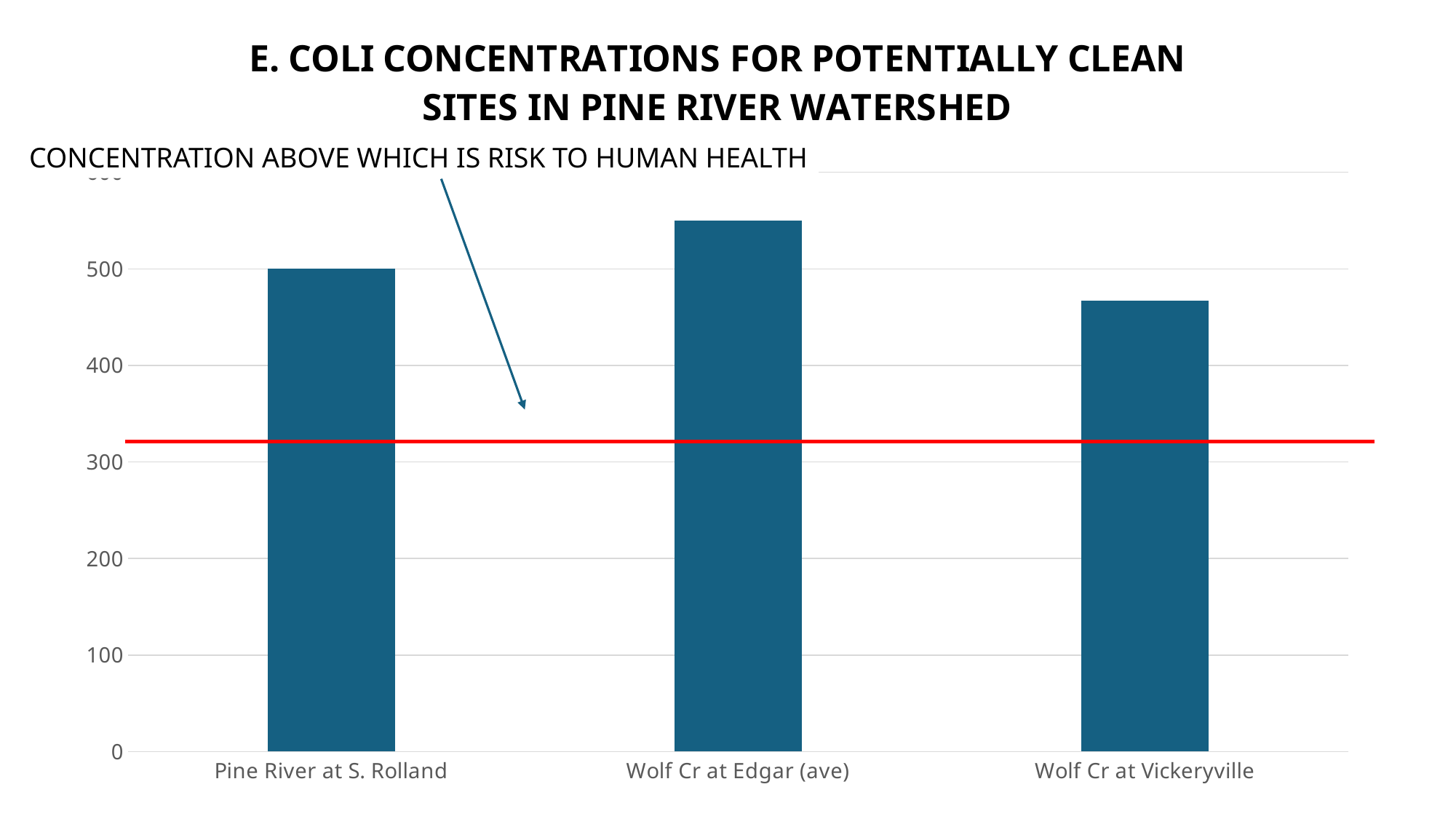
Is the value for Wolf Cr at Edgar (ave) greater or less than 500? greater Is the value for Wolf Cr at Vickeryville greater or less than 500? less What kind of chart is shown on the slide? Bar chart What is the title of the chart? E. COLI CONCENTRATIONS FOR POTENTIALLY CLEAN SITES IN PINE RIVER WATERSHED Which site has the lowest E. coli concentration? Wolf Cr at Vickeryville Is the value for Wolf Cr at Vickeryville greater or less than 400? greater Which is larger, the value for Pine River at S. Rolland or the value for Wolf Cr at Vickeryville? Pine River at S. Rolland What is the E. coli concentration for Pine River at S. Rolland? 500 What does the red horizontal line on the chart represent? Concentration above which is risk to human health Which site has the highest E. coli concentration? Wolf Cr at Edgar (ave) How many sites are shown on the chart? 3 Are all three bars above the red line marking the concentration above which there is risk to human health? Yes